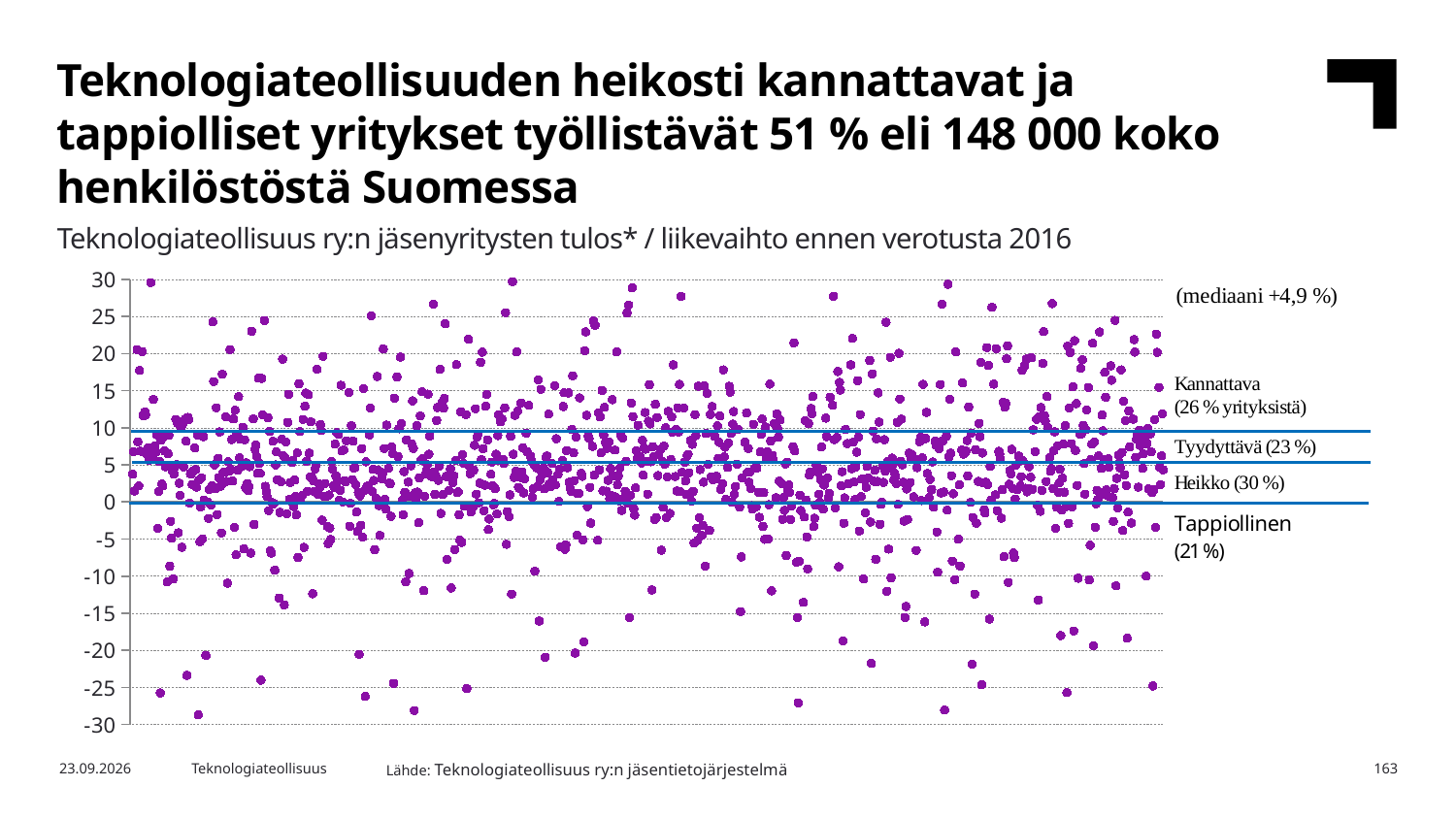
Which profitability category has the largest share of companies? Heikko How many percentage points larger is the Heikko share than the Tappiollinen share? 9 What is the highest value shown on the vertical axis? 30 What share of companies falls into the Tyydyttävä category? 23 % What is the median value stated on the chart? +4,9 % Which category has a larger share of companies, Kannattava or Tyydyttävä? Kannattava What share of companies falls into the Kannattava category? 26 % What share of companies falls into the Heikko category? 30 % What share of companies falls into the Tappiollinen category? 21 % What kind of chart is shown on the slide? Scatter chart How many profitability categories are labelled on the chart? 4 Which profitability category has the smallest share of companies? Tappiollinen